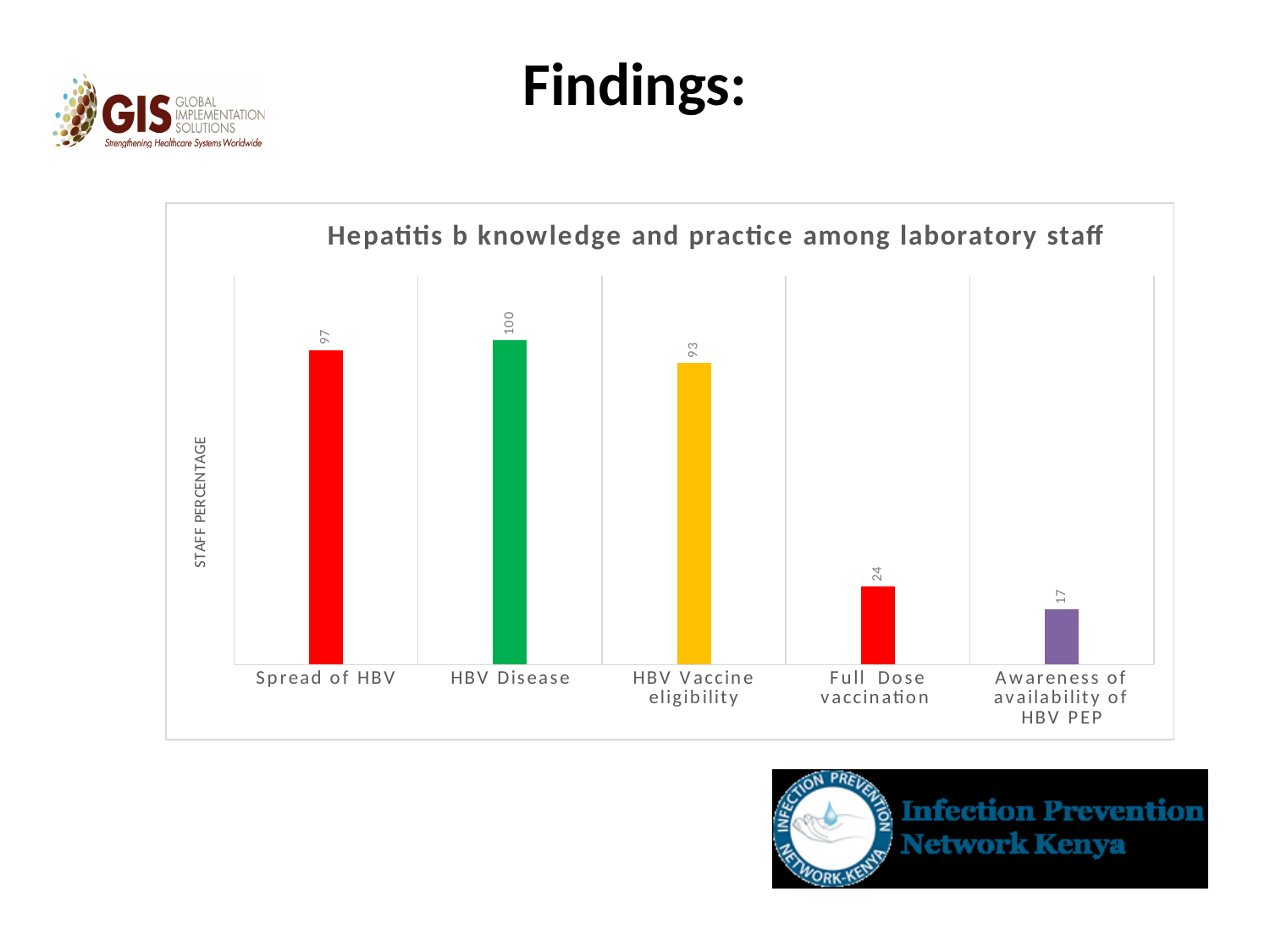
What is the value for HBV Disease? 100 What is the value for Full Dose vaccination? 24 What is the value for HBV Vaccine eligibility? 93 What is the label of the vertical axis? STAFF PERCENTAGE Which category has the highest value? HBV Disease Which category has the lowest value? Awareness of availability of HBV PEP What kind of chart is shown on the slide? Bar chart What is the difference between the values for Spread of HBV and Full Dose vaccination? 73 How many categories are shown on the x axis? 5 What is the title of the chart? Hepatitis b knowledge and practice among laboratory staff Which is larger, the value for Spread of HBV or the value for HBV Vaccine eligibility? Spread of HBV What is the value for Awareness of availability of HBV PEP? 17